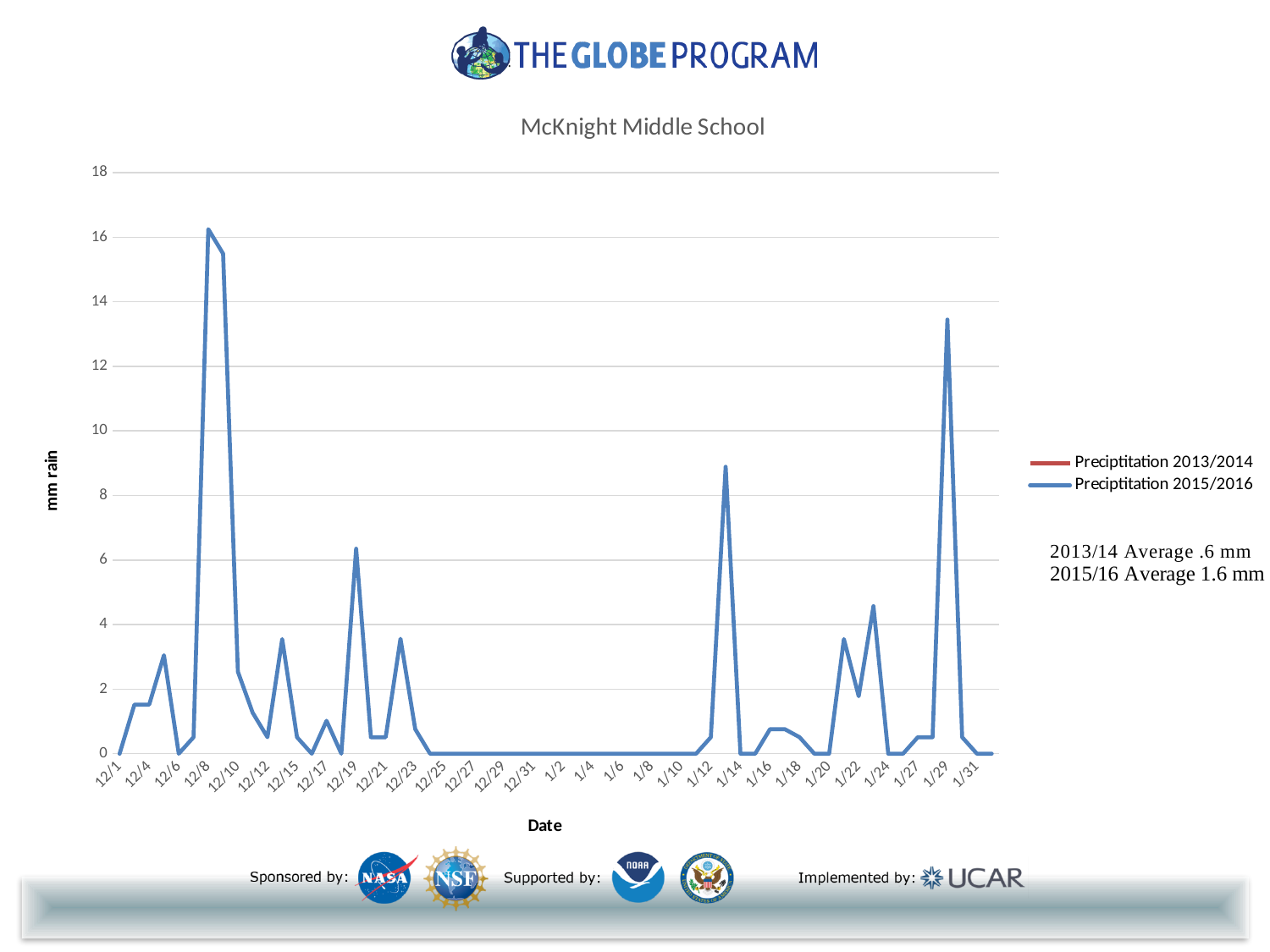
What is the difference between the 2015/16 average and the 2013/14 average stated on the slide? 1 mm Which is higher for Preciptitation 2015/2016: the peak on 12/8 or the peak on 1/29? 12/8 Is the Preciptitation 2015/2016 value on 12/4 greater or less than 2? less What is the title of the chart? McKnight Middle School Is the Preciptitation 2015/2016 value on 12/19 greater or less than 4? greater On which date does the Preciptitation 2015/2016 line reach its highest value? 12/8 Is the Preciptitation 2015/2016 value on 12/8 greater or less than 14? greater How many series does the legend list? 2 What kind of chart is shown on the slide? line chart What is the 2015/16 average precipitation stated on the slide? 1.6 mm What is the label on the vertical axis? mm rain